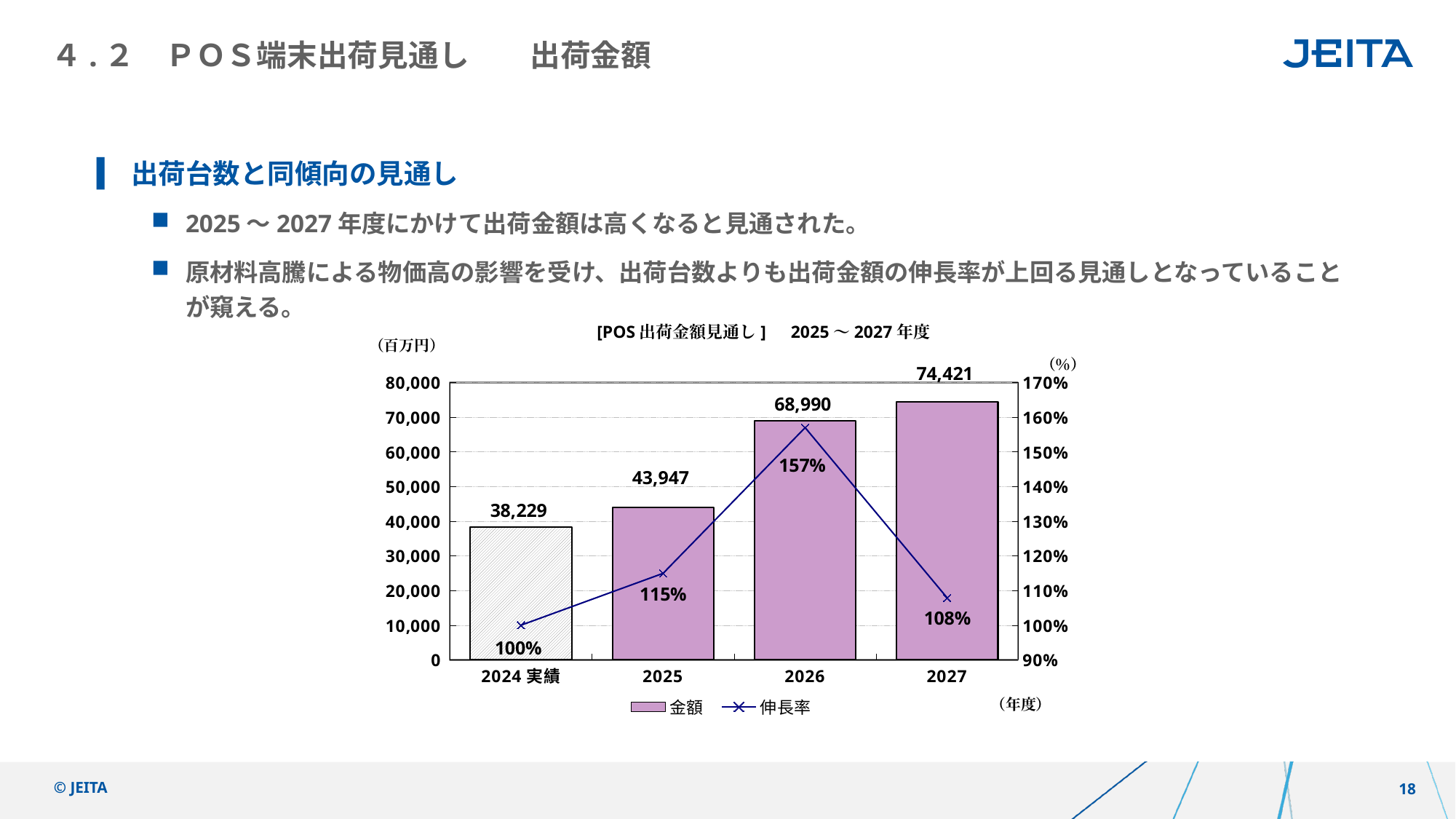
What is the 金額 (amount) value for 2026? 68,990 What is the 伸長率 (growth rate) value for 2025? 115% How many years are shown on the x axis? 4 Which is larger, the 伸長率 for 2026 or for 2027? 2026 How many series does the legend list? 2 Which year has the lowest 伸長率 value? 2024 実績 Is the 金額 value for 2025 greater or less than 40,000? greater What kind of chart is used to show the 金額 series? bar chart What is the 金額 value for 2024 実績? 38,229 What is the difference in 金額 between 2027 and 2026? 5,431 Which year has the highest 金額 value? 2027 Do the 金額 values rise or fall from 2024 実績 to 2027? rise